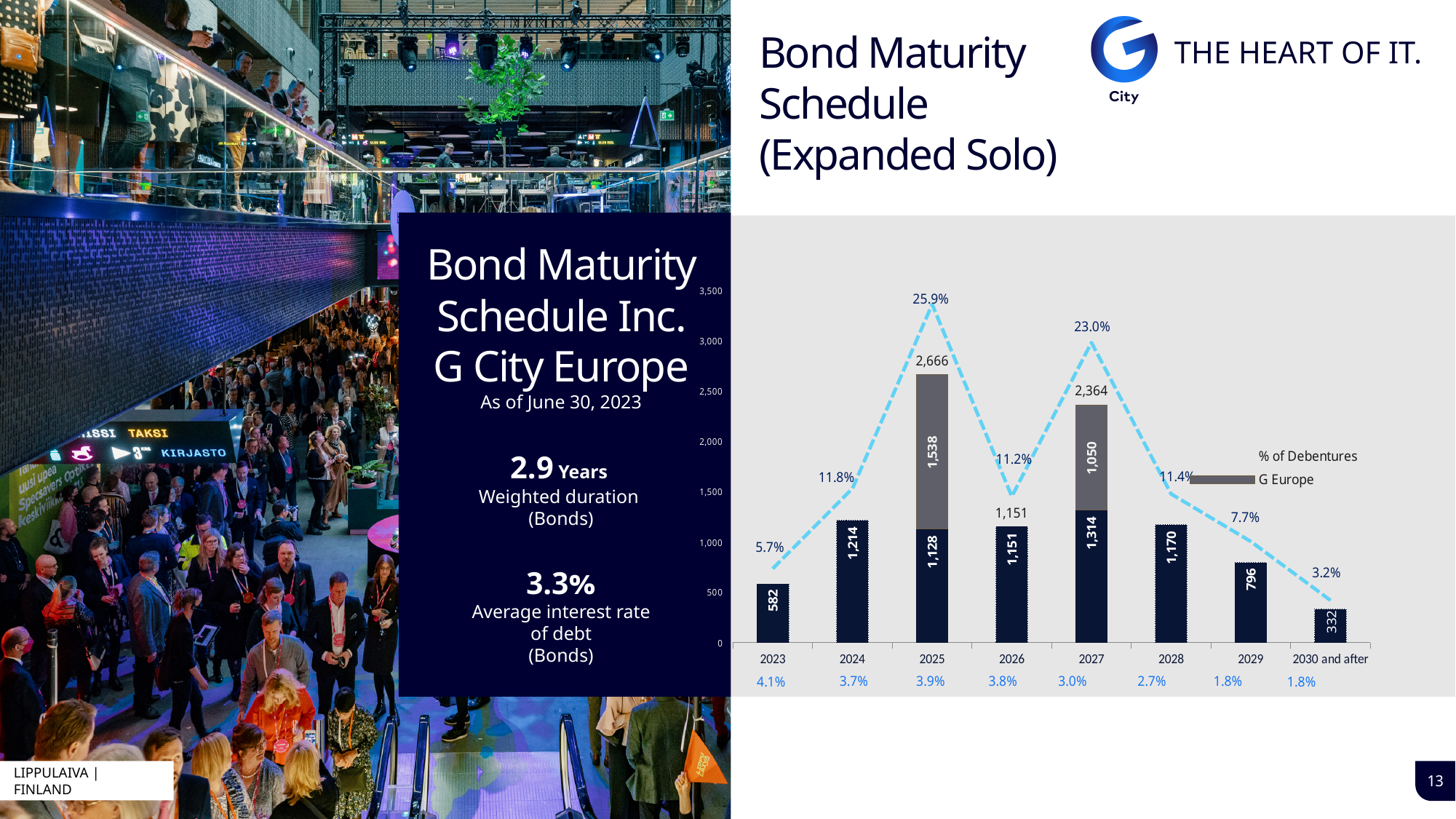
How many categories are shown on the x axis? 8 What kind of chart is this? Stacked bar chart with a line Which bar is larger, 2028 or 2029? 2028 What is the G Europe portion of the 2025 bar? 1,538 Which category has the lowest bar? 2030 and after Which year has the highest % of Debentures? 2025 What is the total of the stacked bar for 2025? 2,666 Do the bar values rise or fall from 2027 to 2030 and after? Fall What is the value of the bar for 2023? 582 What is the total of the stacked bar for 2027? 2,364 What is the difference between the bar values for 2024 and 2026? 63 What is the % of Debentures value for 2027? 23.0%